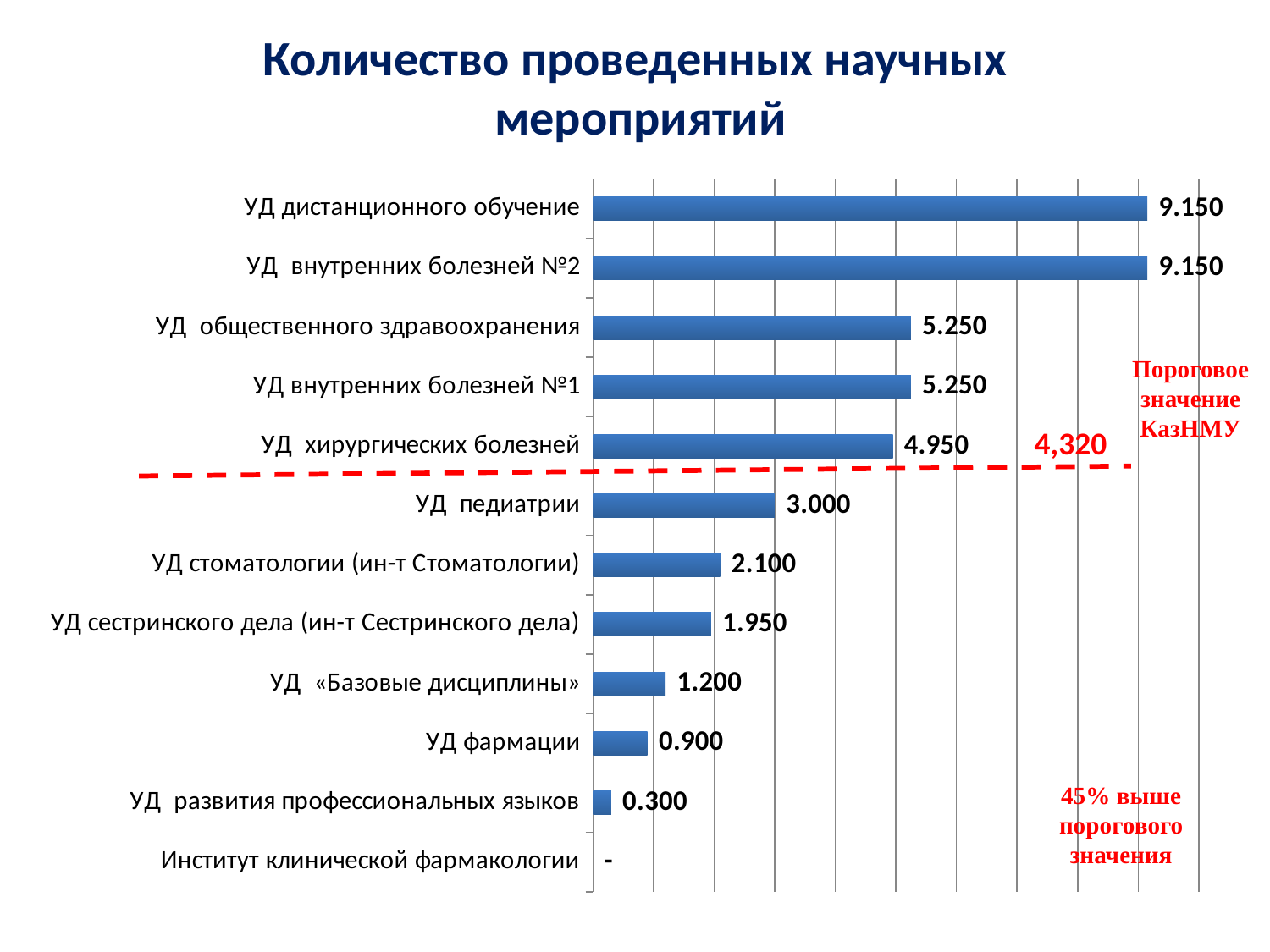
Which category has the lowest value among those with a bar? УД развития профессиональных языков What is the difference between the values for УД внутренних болезней №1 and УД педиатрии? 2.250 Which is larger, the value for УД стоматологии (ин-т Стоматологии) or the value for УД «Базовые дисциплины»? УД стоматологии (ин-т Стоматологии) What is the value for УД фармации? 0.900 What is the value for УД педиатрии? 3.000 What is the value for УД сестринского дела (ин-т Сестринского дела)? 1.950 What type of chart is shown on the slide? bar chart Do the values rise or fall going from the top bar to the bottom bar? fall What is the highest value shown on the chart? 9.150 How many categories are shown on the chart? 12 What is the value for УД хирургических болезней? 4.950 What threshold value (Пороговое значение КазНМУ) is marked by the red dashed line? 4,320